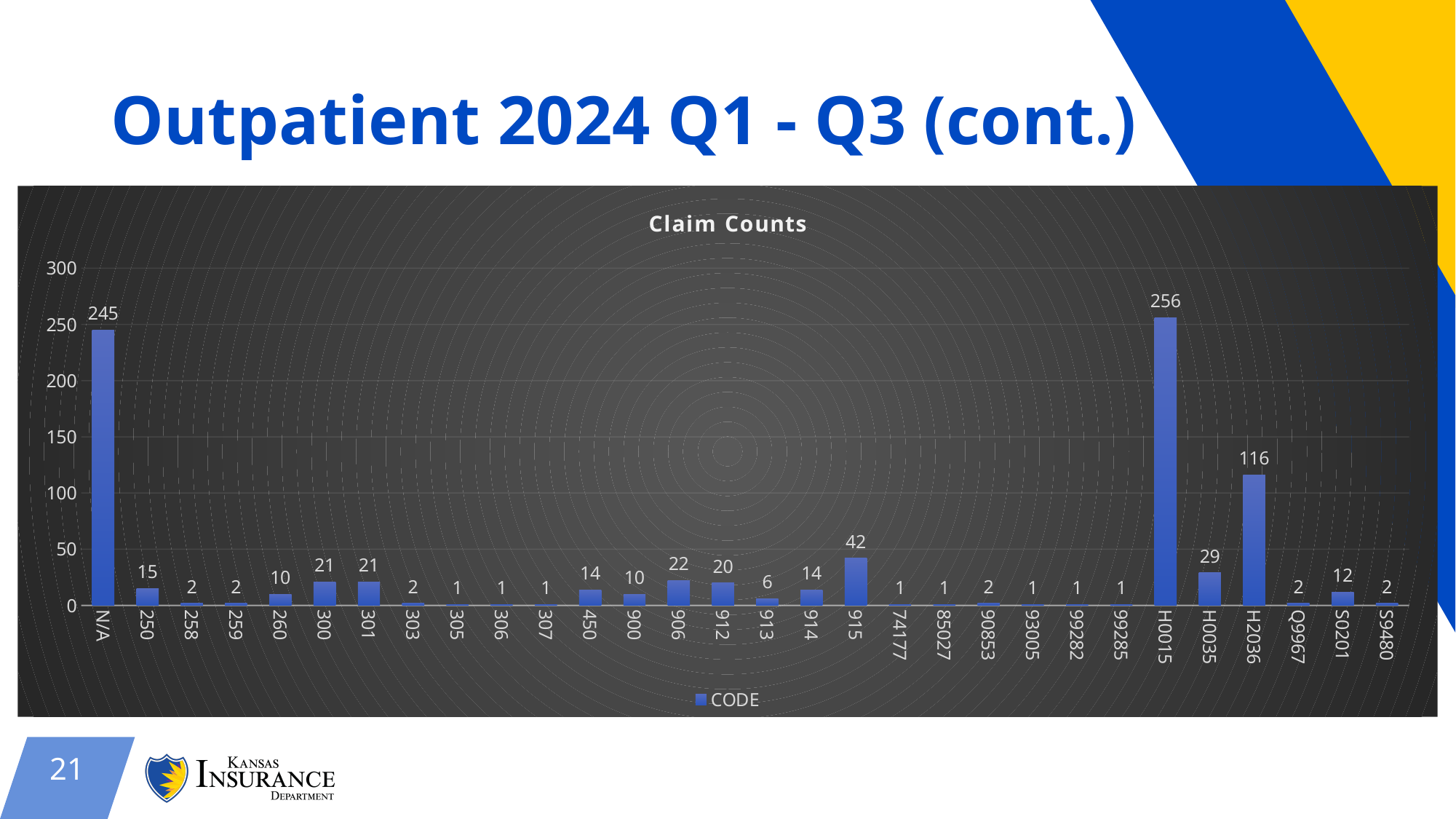
How many codes (categories) are shown on the x axis? 30 What is the claim count for code H0015? 256 What is the claim count for code H2036? 116 What is the difference between the claim counts for H0015 and N/A? 11 What is the difference between the claim counts for H2036 and H0035? 87 What is the claim count for the N/A category? 245 What is the title of the chart? Claim Counts Which has a larger claim count, code 915 or code H0035? 915 Is the claim count for H2036 greater or less than 100? greater What type of chart is shown on the slide? Bar chart What is the claim count for code 915? 42 Which code has the highest claim count? H0015